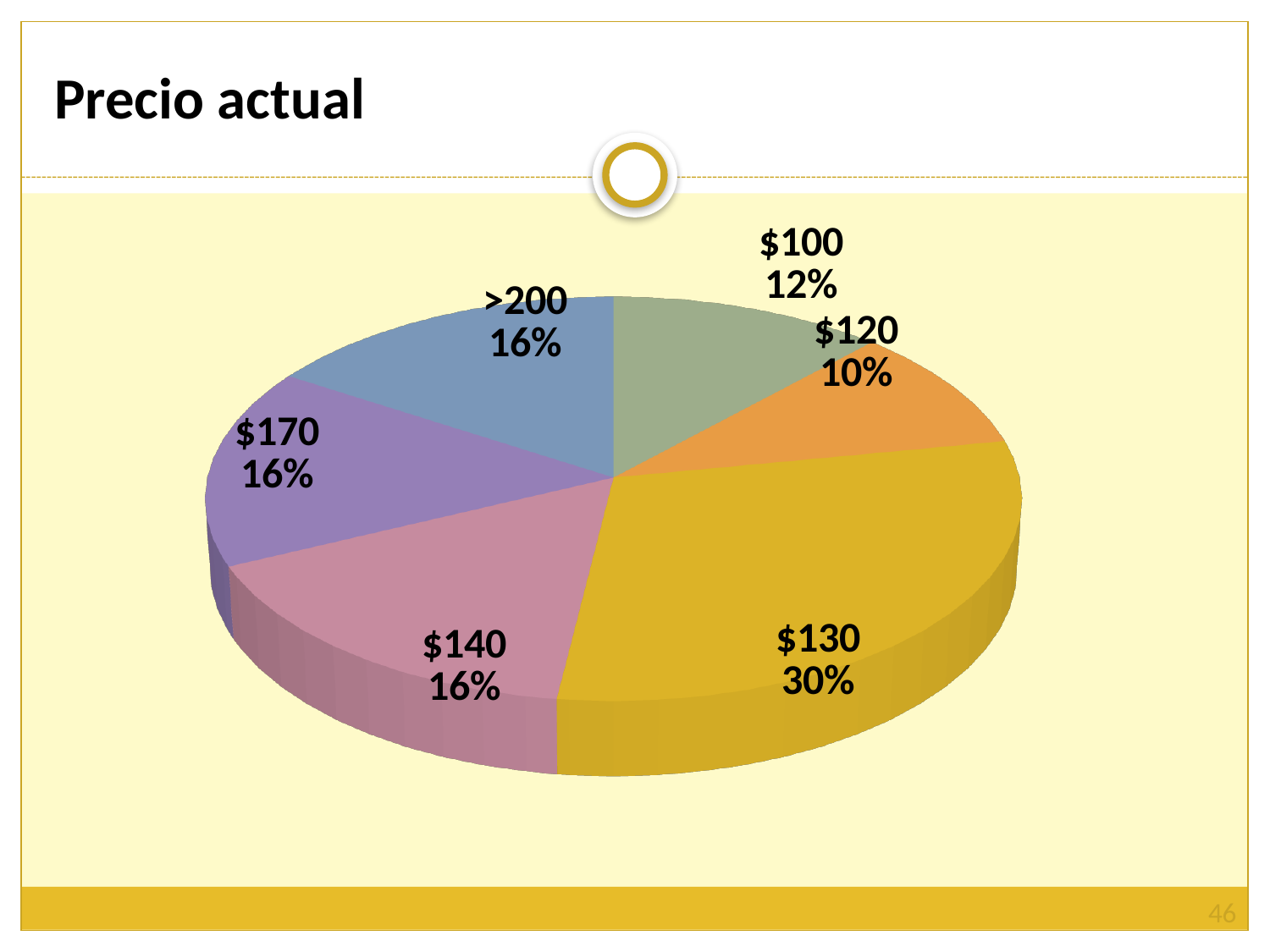
What share of the pie does the $120 slice represent? 10% What is the difference in percentage points between the $100 slice and the $120 slice? 2% What type of chart is shown on the slide? pie chart How many slices does the pie chart have? 6 What share of the pie does the >200 slice represent? 16% Which slice is larger, $100 or $120? $100 What is the title of the slide containing the pie chart? Precio actual Which price category has the smallest share of the pie? $120 What is the difference in percentage points between the $130 slice and the $140 slice? 14% What share of the pie does the $130 slice represent? 30% Which price category has the largest share of the pie? $130